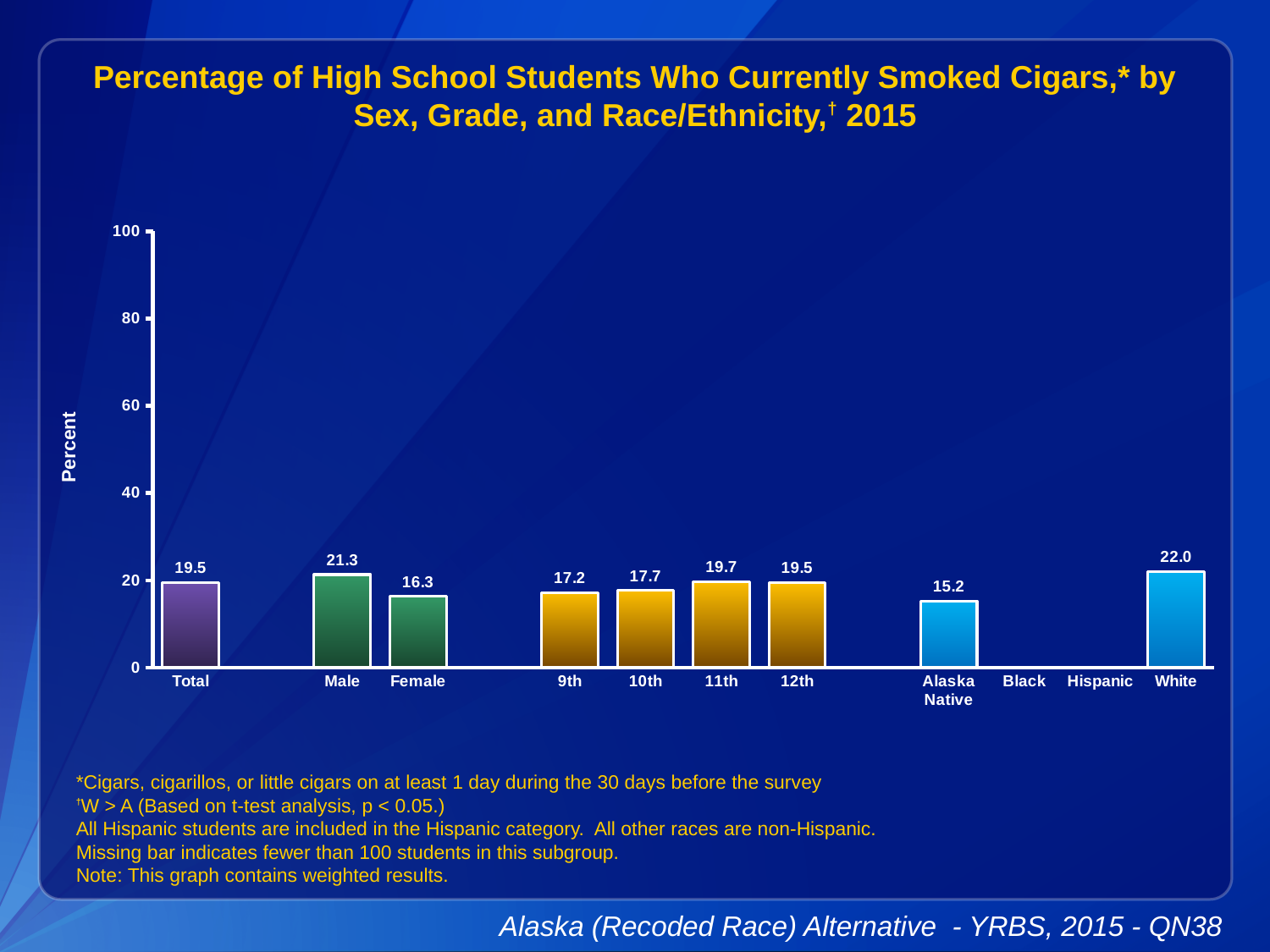
How many bars are plotted on the chart? 9 Which category has the highest value? White What kind of chart is this? bar chart What is the value for Alaska Native? 15.2 Do the values rise or fall from 9th grade to 11th grade? rise Which is larger, the value for 11th or the value for 9th? 11th Is the value for White greater or less than 20? greater What is the difference between the Male and Female values? 5.0 Which category with a plotted bar has the lowest value? Alaska Native What is the label on the y axis? Percent What is the value for Total? 19.5 What is the value for Female? 16.3